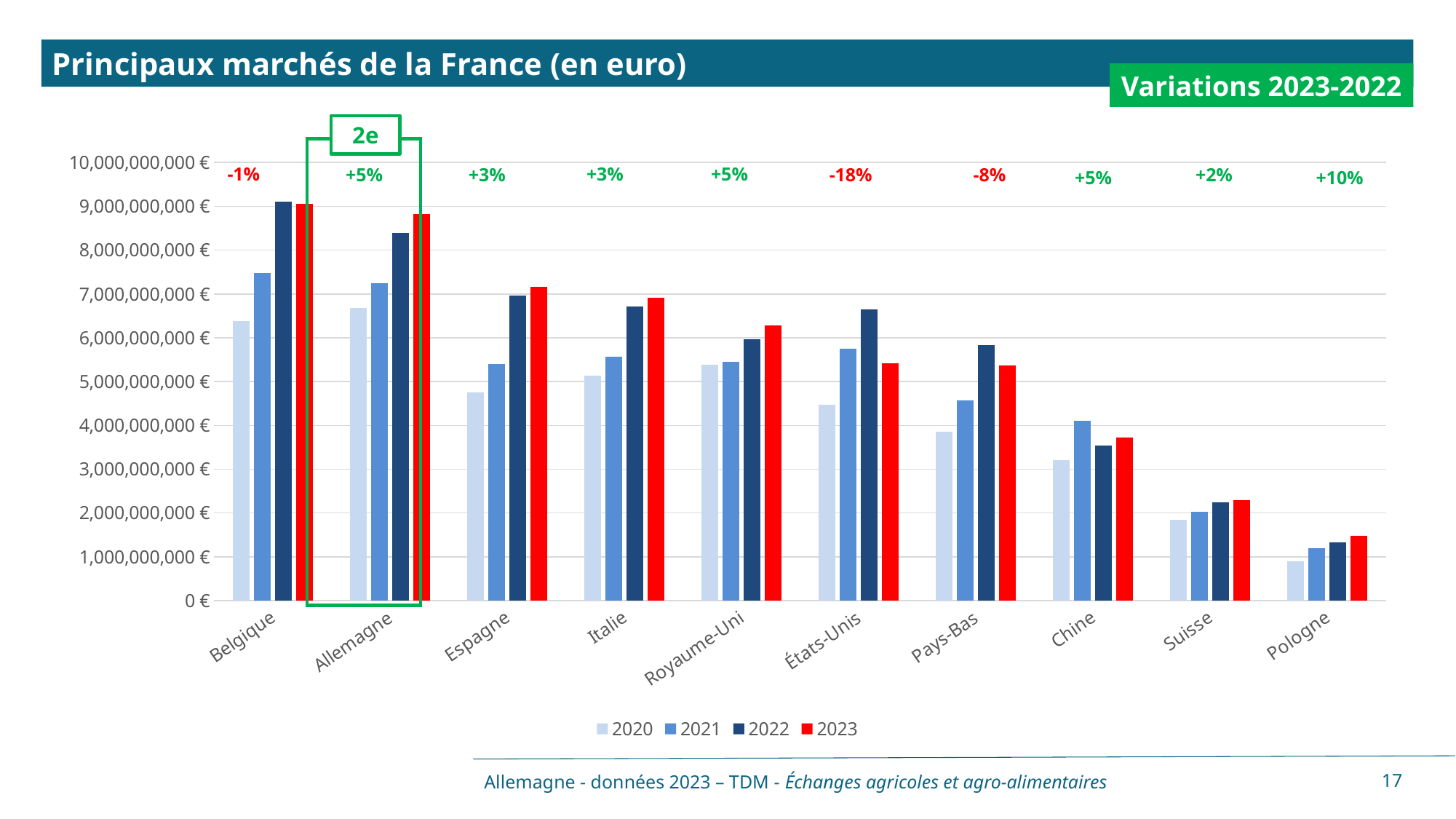
What is the 2023-2022 variation shown for États-Unis? -18% How many series does the legend list? 4 Which country has the lowest 2023 value? Pologne Which is larger, the 2022 value for Belgique or the 2022 value for Allemagne? Belgique How many countries are shown on the x axis of the chart? 10 Is the 2023 value for Chine greater or less than 4,000,000,000 €? less Which country is highlighted with the green box labelled "2e"? Allemagne What kind of chart is shown on the slide? Bar chart Is the 2022 value for Italie greater or less than 6,000,000,000 €? greater Which country shows the largest decrease in the 2023-2022 variations? États-Unis What is the 2023-2022 variation shown for Pologne? +10% What is the 2023-2022 variation shown for Belgique? -1%